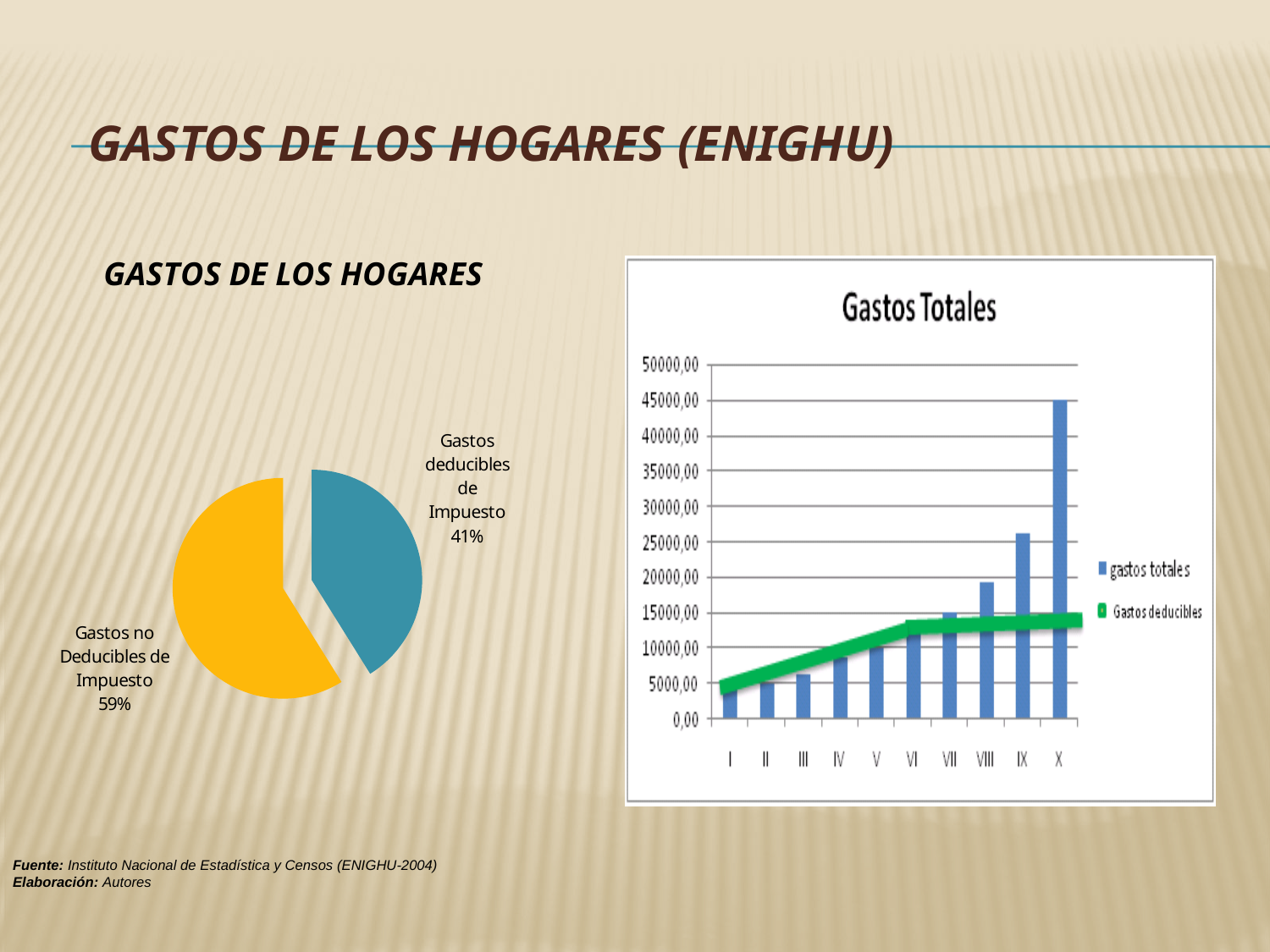
In the pie chart GASTOS DE LOS HOGARES, what share is Gastos no Deducibles de Impuesto? 59% In the Gastos Totales chart, how many categories are shown on the x axis? 10 How many slices does the pie chart GASTOS DE LOS HOGARES have? 2 In the pie chart GASTOS DE LOS HOGARES, what share is Gastos deducibles de Impuesto? 41% In the Gastos Totales chart, which category has the lowest gastos totales? I In the Gastos Totales chart, is the gastos totales value for X greater or less than 40000,00? greater What kind of chart is GASTOS DE LOS HOGARES on the left of the slide? Pie chart In the Gastos Totales chart, is the gastos totales value for I greater or less than 5000,00? less In the Gastos Totales chart, how many series does the legend list? 2 In the pie chart GASTOS DE LOS HOGARES, which slice is larger, Gastos deducibles de Impuesto or Gastos no Deducibles de Impuesto? Gastos no Deducibles de Impuesto In the Gastos Totales chart, do the gastos totales bars rise or fall from category I to category X? rise In the Gastos Totales chart, which category has the highest gastos totales? X